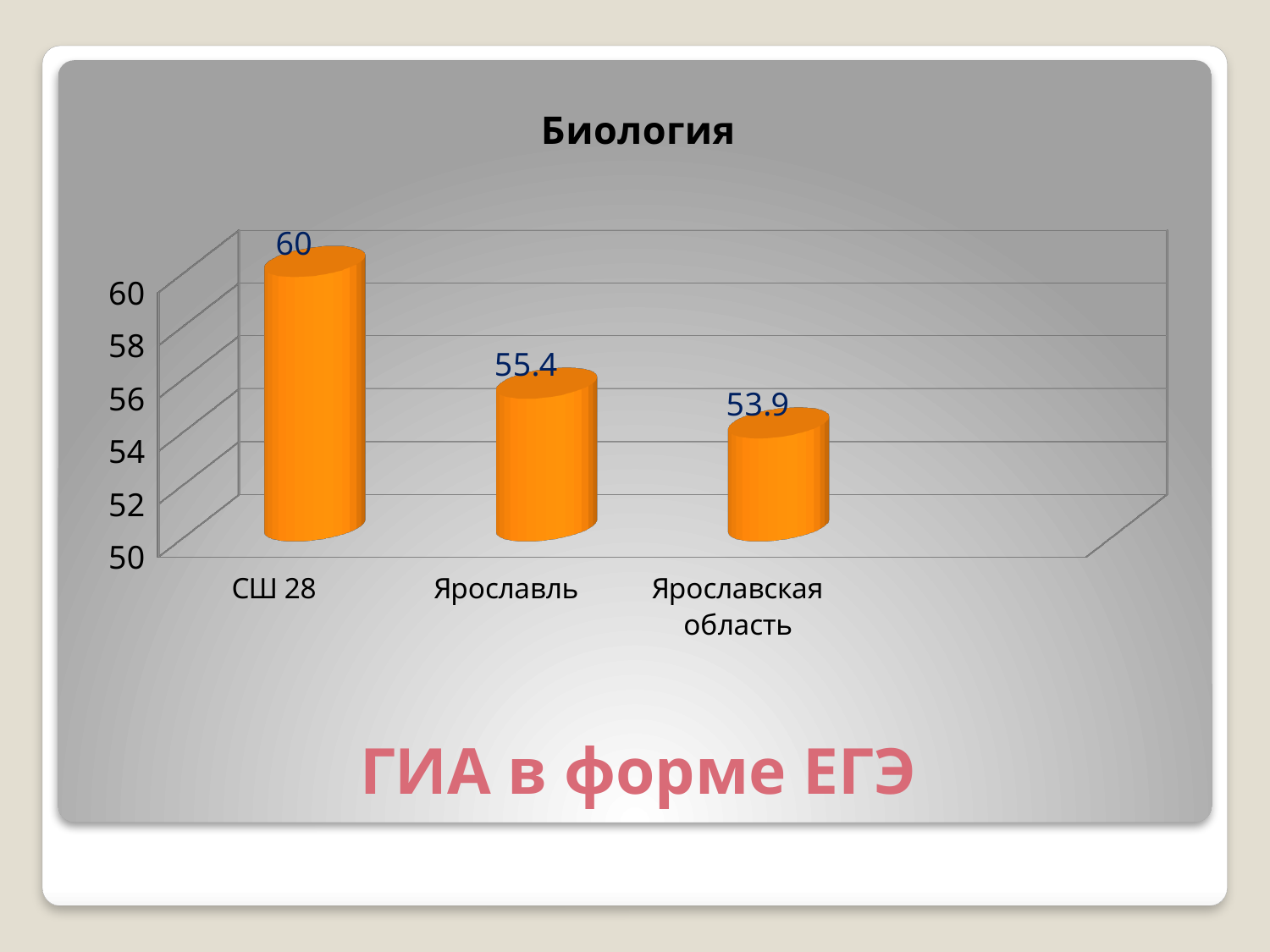
What is the value for СШ 28? 60 Which category has the lowest value? Ярославская область Which is larger, the value for Ярославль or the value for Ярославская область? Ярославль What is the value for Ярославская область? 53.9 What is the difference between the values for Ярославль and Ярославская область? 1.5 How many categories are shown on the chart? 3 What is the value for Ярославль? 55.4 Is the value for Ярославская область greater or less than 54? less What kind of chart is shown on the slide? bar chart What is the title of the chart? Биология Which category has the highest value? СШ 28 What is the difference between the values for СШ 28 and Ярославль? 4.6